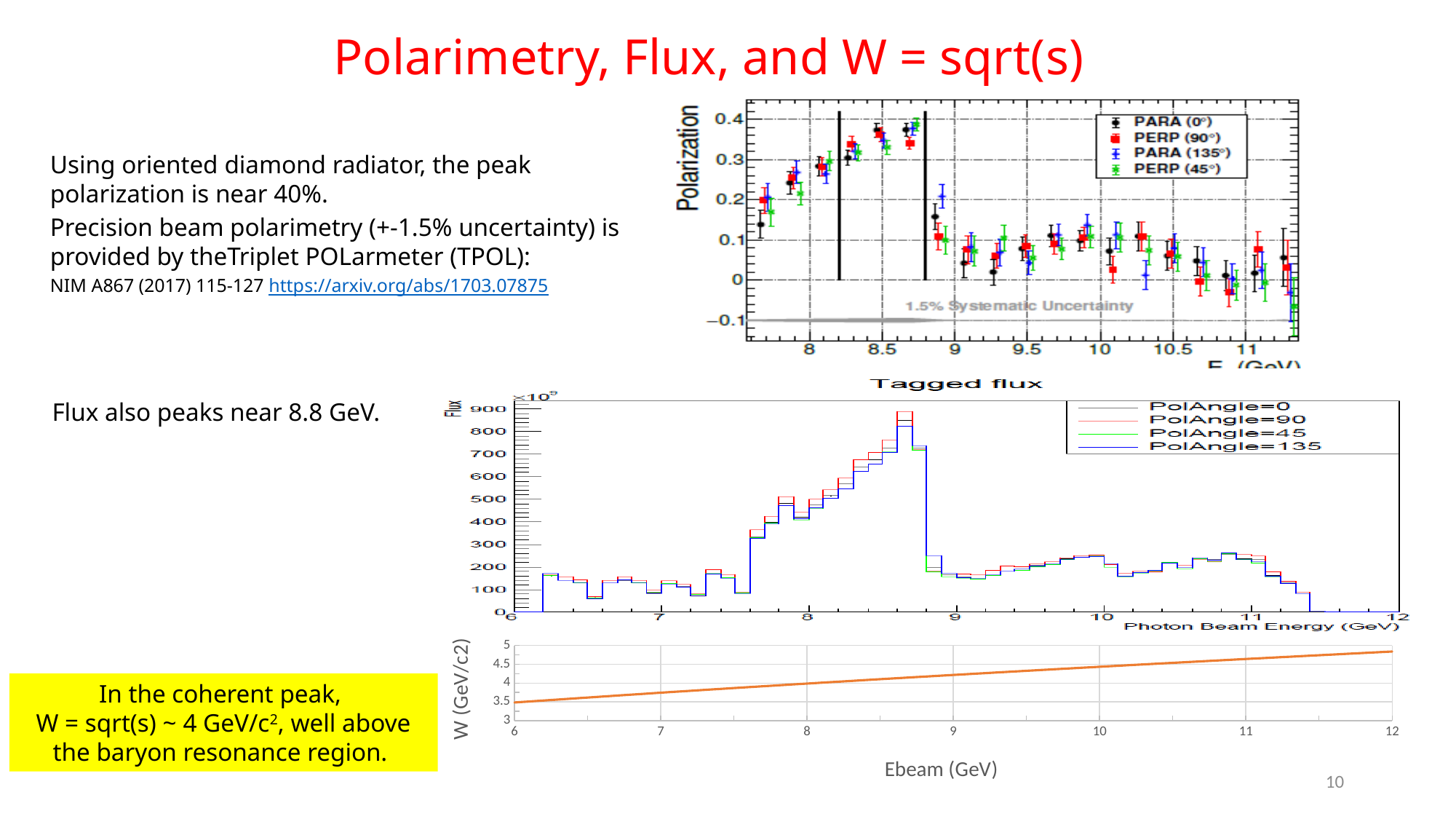
On the Tagged flux chart, is the flux at a photon beam energy of 7 GeV greater or less than 200 (×10^9)? less What kind of chart is the bottom chart of W (GeV/c2) versus Ebeam (GeV)? line chart On the Polarization chart (top right), how many series does the legend list? 4 On the bottom W (GeV/c2) chart, do the values rise or fall as Ebeam increases from 6 to 12 GeV? rise What is the x-axis label of the bottom W (GeV/c2) chart? Ebeam (GeV) On the bottom W (GeV/c2) chart, is the value of W at Ebeam = 12 GeV greater or less than 4.5? greater On the Polarization chart (top right), is the polarization at 8.5 GeV greater or less than 0.3? greater On the Tagged flux chart, how many series does the legend list? 4